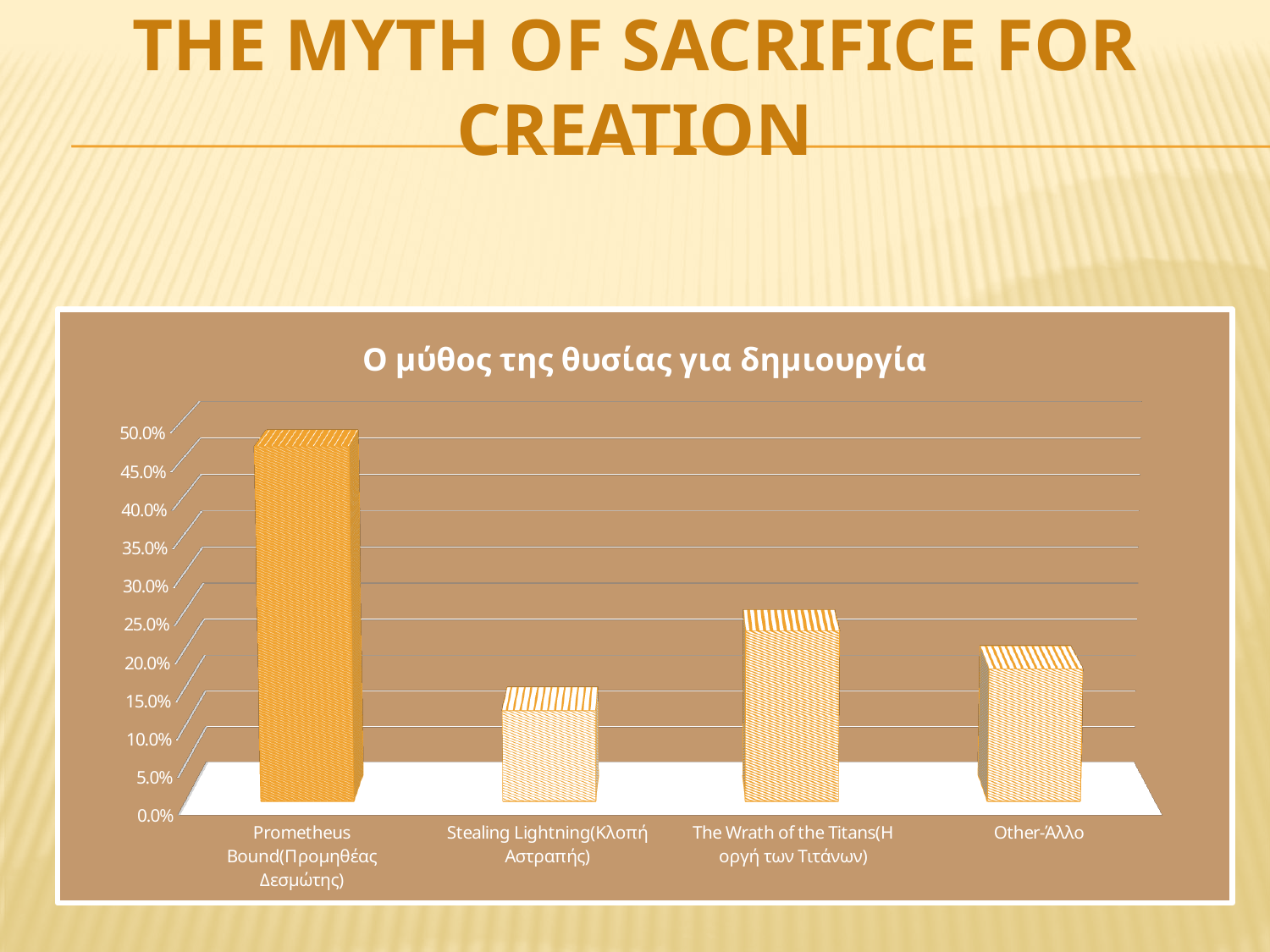
Is the value for Prometheus Bound(Προμηθέας Δεσμώτης) greater or less than 40.0%? greater Is the value for Other-Άλλο greater or less than 30.0%? less Is the value for The Wrath of the Titans(Η οργή των Τιτάνων) greater or less than 20.0%? greater Which category has the lowest value in the chart? Stealing Lightning(Κλοπή Αστραπής) Which is larger: the value for Prometheus Bound(Προμηθέας Δεσμώτης) or the value for Stealing Lightning(Κλοπή Αστραπής)? Prometheus Bound(Προμηθέας Δεσμώτης) What kind of chart is shown on the slide? bar chart Which is larger: the value for The Wrath of the Titans(Η οργή των Τιτάνων) or the value for Other-Άλλο? The Wrath of the Titans(Η οργή των Τιτάνων) How many categories are plotted in the chart? 4 Which category has the highest value in the chart? Prometheus Bound(Προμηθέας Δεσμώτης) What is the title of the chart? Ο μύθος της θυσίας για δημιουργία